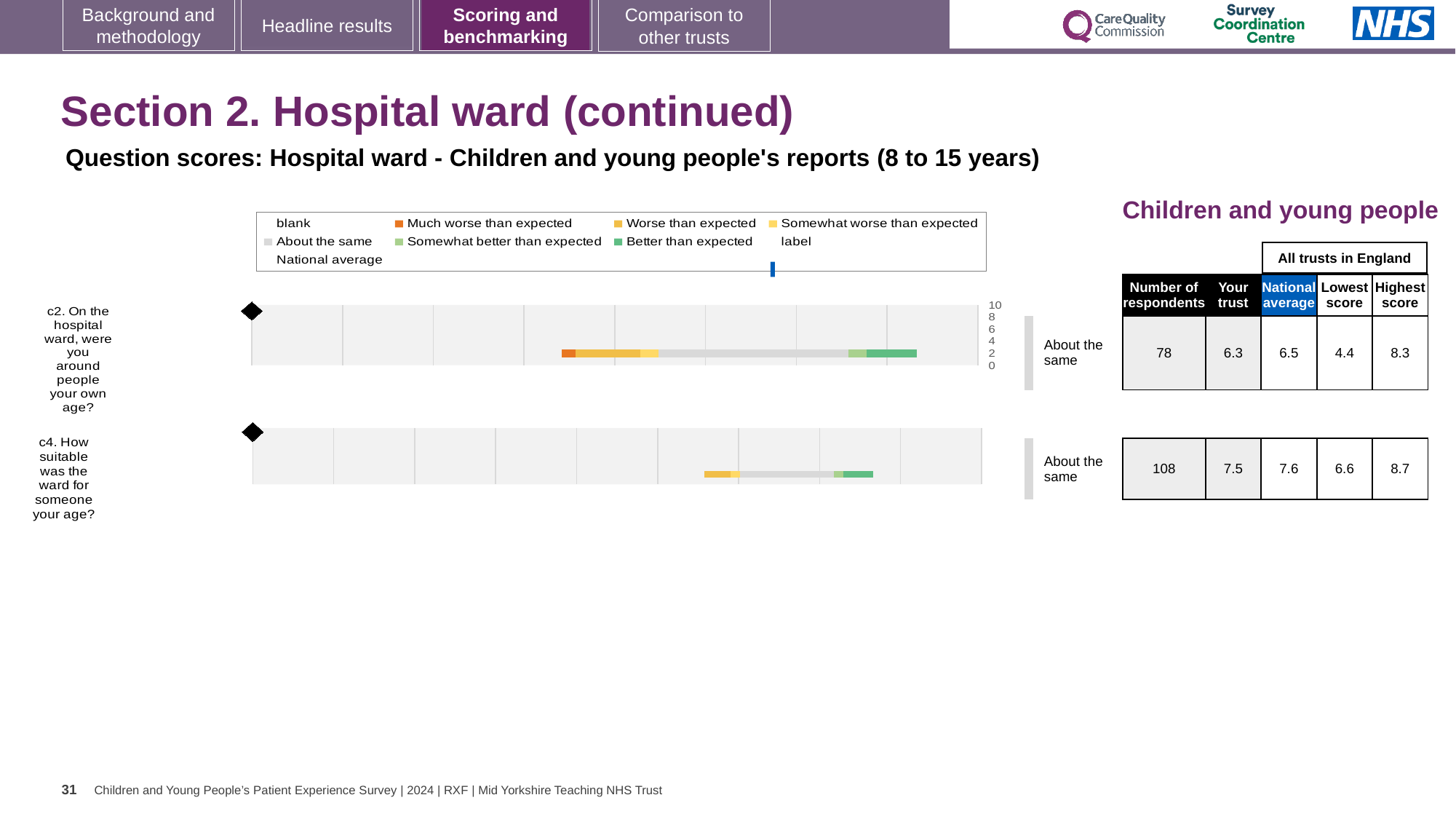
What is the difference between the highest and lowest scores across all trusts in England for question c2? 3.9 How many respondents answered question c2? 78 How many respondents answered question c4? 108 What is the national average score for question c4 (How suitable was the ward for someone your age?)? 7.6 For question c2, which is larger: the 'Your trust' score or the national average? National average What is the 'Your trust' score for question c2 (On the hospital ward, were you around people your own age?)? 6.3 What is the highest score among all trusts in England for question c2? 8.3 What kind of chart is used to show the question scores on this slide? bar chart What is the lowest score among all trusts in England for question c4? 6.6 Which question has the higher 'Your trust' score, c2 or c4? c4 How many questions are plotted in the chart on this slide? 2 What benchmark category is shown for question c4? About the same